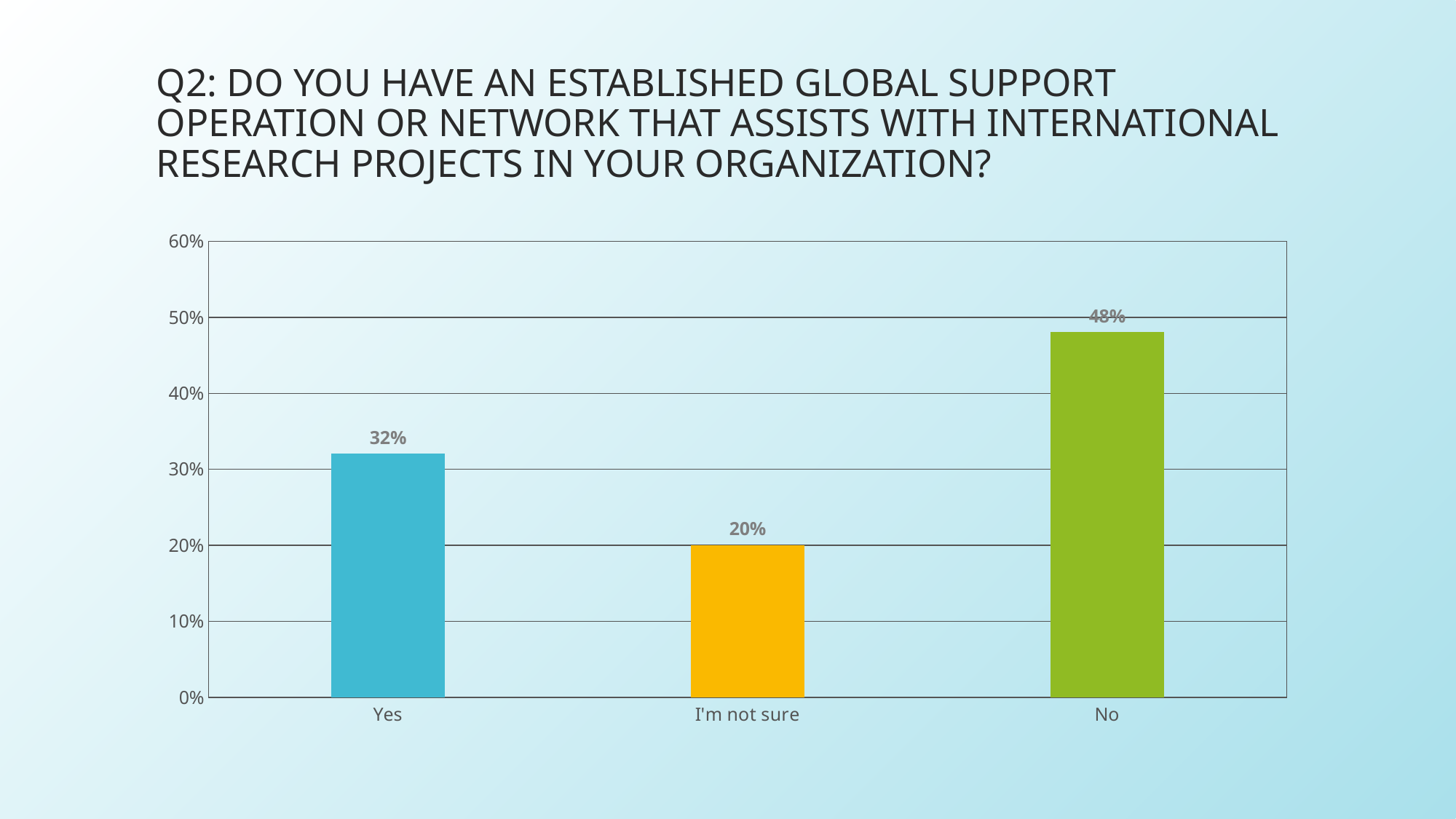
What percentage of respondents answered "No"? 48% Is the value for "No" greater or less than 40%? greater What is the difference in percentage points between the "No" and "Yes" responses? 16% What type of chart is shown on the slide? Bar chart What percentage of respondents answered "Yes"? 32% What colour is the bar for "I'm not sure"? Yellow Which is larger, the percentage for "Yes" or for "No"? No How many response categories are shown on the chart? 3 Which response has the highest percentage? No What is the difference in percentage points between the "Yes" and "I'm not sure" responses? 12% What percentage of respondents answered "I'm not sure"? 20% Which response has the lowest percentage? I'm not sure